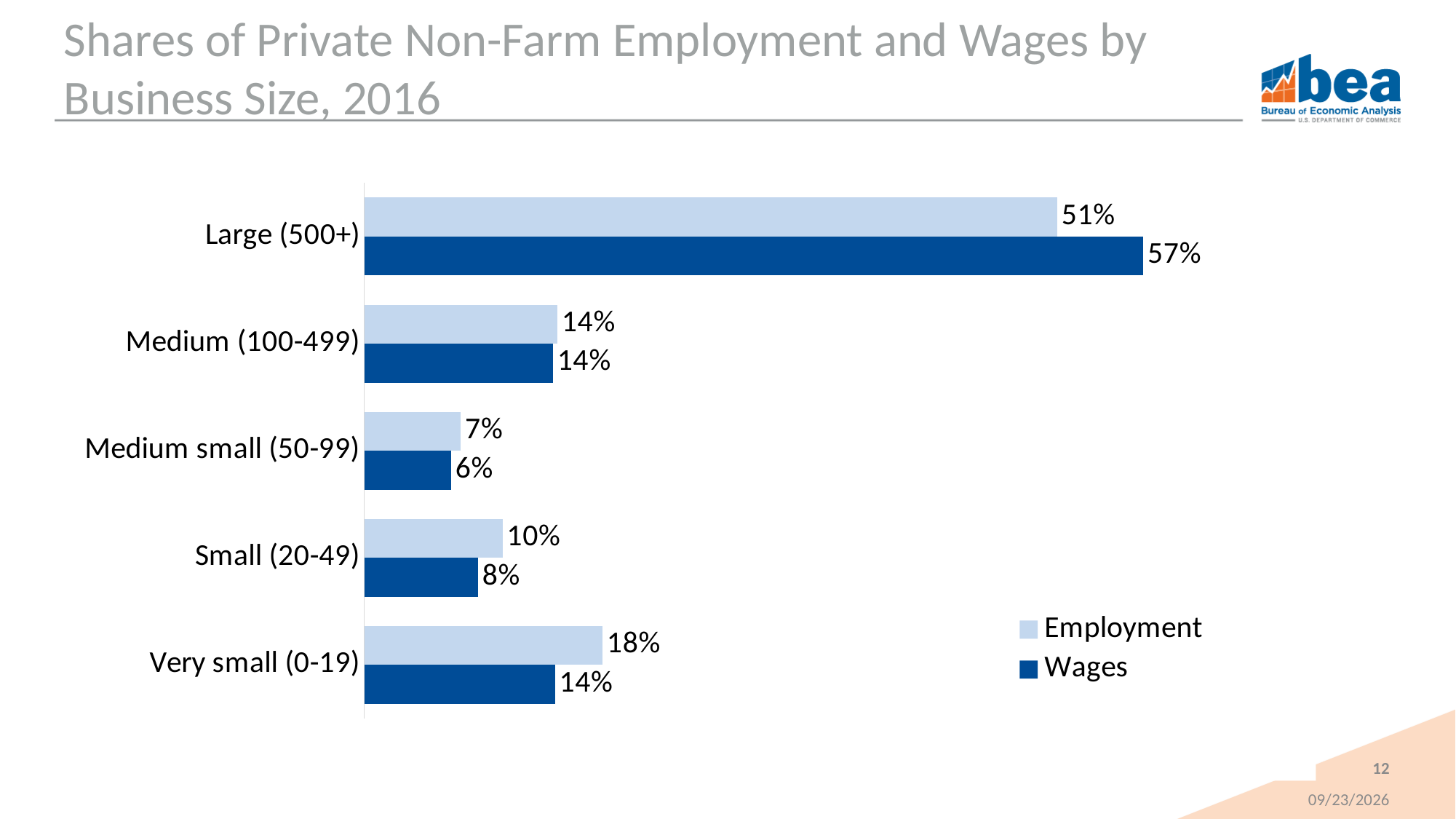
What is the difference between the Wages share and the Employment share for Large (500+) businesses? 6% Which series is shown in dark blue in the legend? Wages How many series does the legend list? 2 Which business size category has the highest Wages share? Large (500+) Which business size category has the lowest Employment share? Medium small (50-99) For Small (20-49) businesses, which is larger: the Employment share or the Wages share? Employment What is the Employment share for Large (500+) businesses? 51% What kind of chart is shown on the slide? Bar chart How many business size categories are shown on the chart? 5 What is the Wages share for Medium small (50-99) businesses? 6% What is the Wages share for Very small (0-19) businesses? 14% What is the difference between the Employment share and the Wages share for Very small (0-19) businesses? 4%